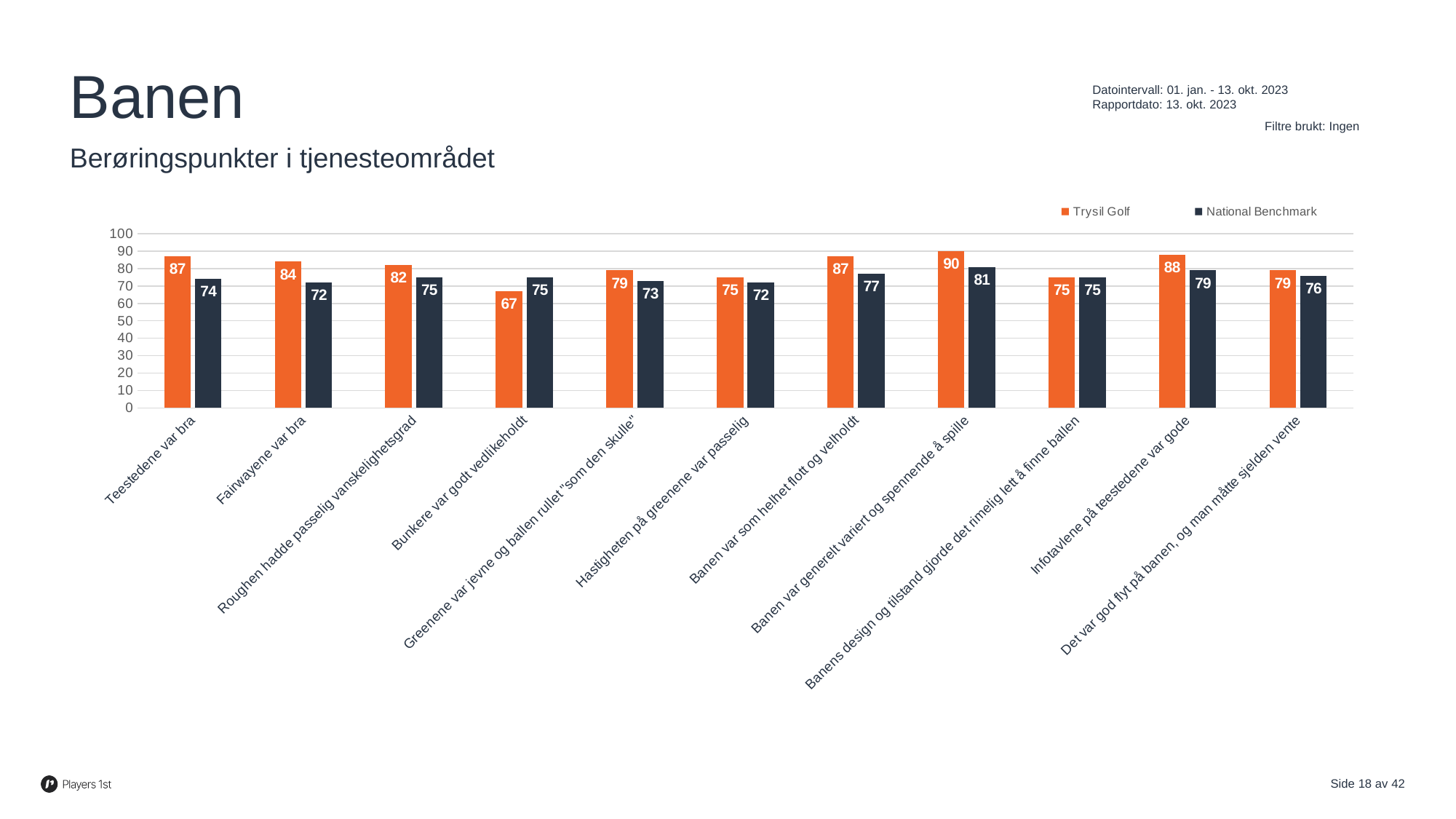
Is the Trysil Golf value for "Infotavlene på teestedene var gode" greater or less than 80? greater Which category has the lowest Trysil Golf value? Bunkere var godt vedlikeholdt What is the Trysil Golf value for "Teestedene var bra"? 87 What is the National Benchmark value for "Banen var generelt variert og spennende å spille"? 81 What is the difference between the Trysil Golf and National Benchmark values for "Fairwayene var bra"? 12 What is the National Benchmark value for "Bunkere var godt vedlikeholdt"? 75 How many categories are shown on the x axis of the chart? 11 Which category has the highest Trysil Golf value? Banen var generelt variert og spennende å spille For "Bunkere var godt vedlikeholdt", which is larger: the Trysil Golf value or the National Benchmark value? National Benchmark How many series does the chart legend list? 2 Which series is shown in orange in the chart? Trysil Golf What kind of chart is shown on the slide? Bar chart